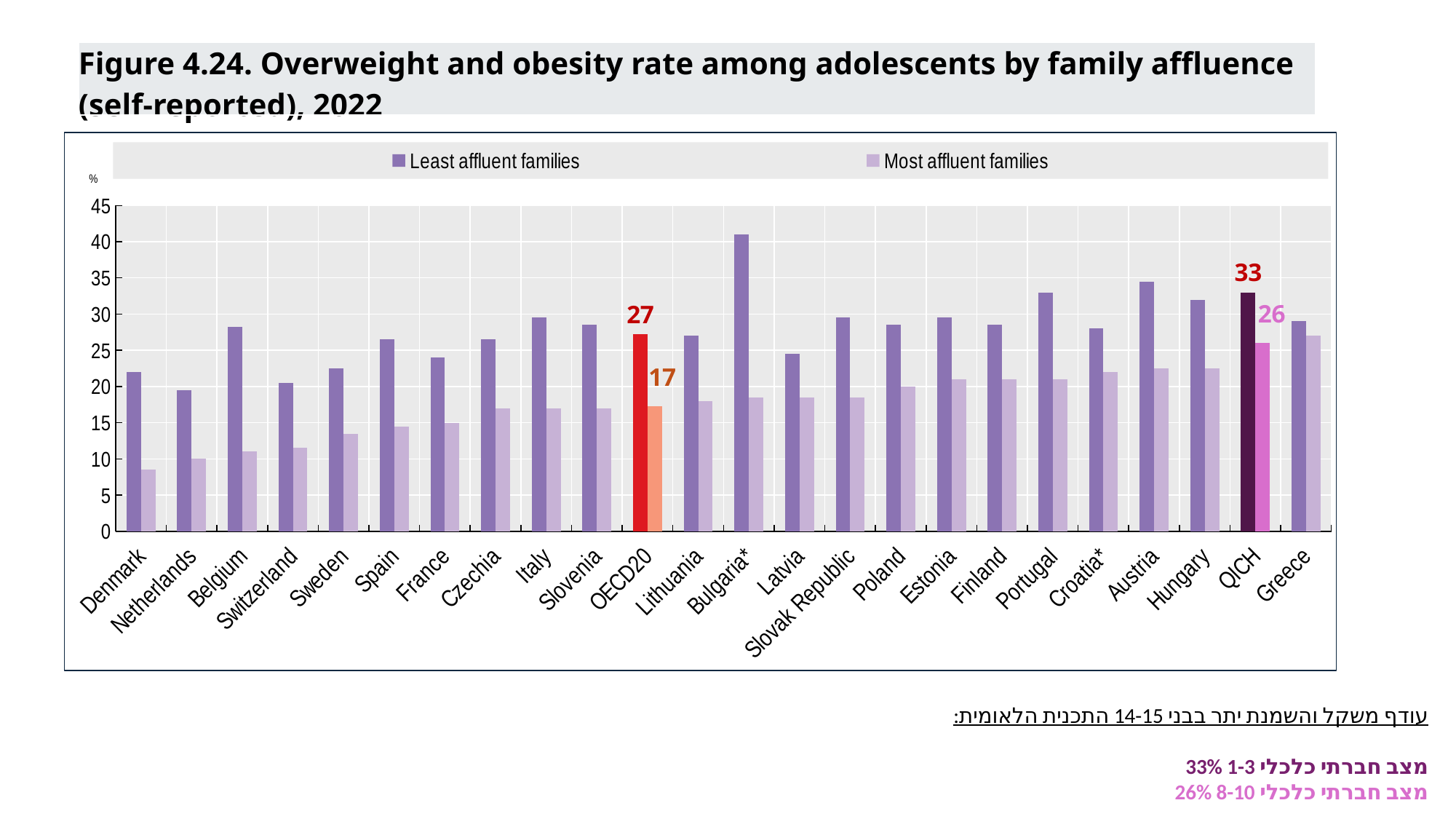
What is the value for Most affluent families for QICH? 26 Is the Least affluent families value for Bulgaria* greater or less than 35? greater How many series does the legend list? 2 Is the Most affluent families value for Denmark greater or less than 10? less What is the value for Most affluent families for OECD20? 17 What is the value for Least affluent families for QICH? 33 Which is larger, the Least affluent families value for QICH or for OECD20? QICH What is the difference between the Least affluent and Most affluent families values for OECD20? 10 Which country has the lowest value for Most affluent families? Denmark Which country has the highest value for Least affluent families? Bulgaria* What is the value for Least affluent families for OECD20? 27 What is the difference between the Least affluent and Most affluent families values for QICH? 7